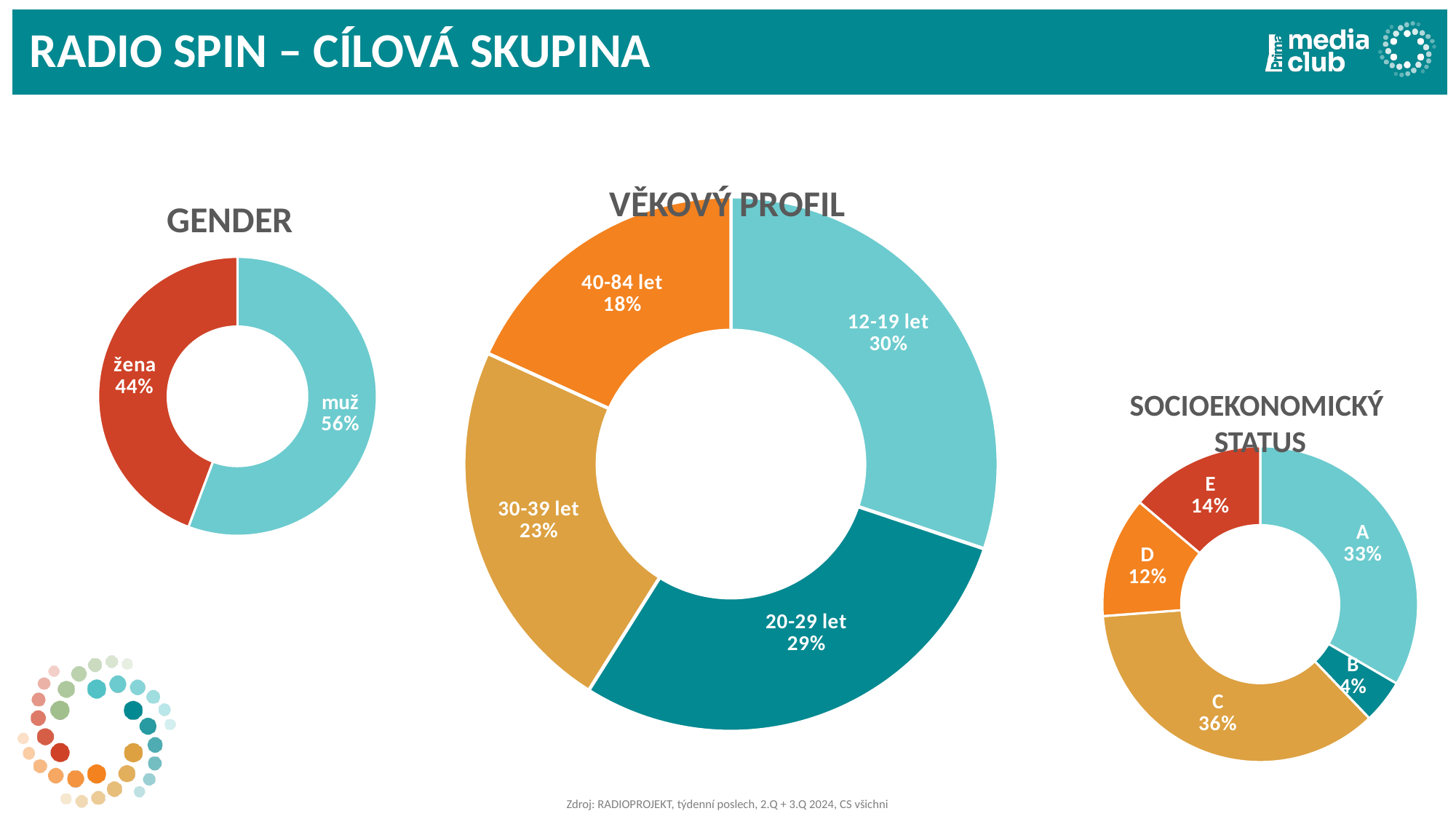
In the VĚKOVÝ PROFIL chart, what is the share for 20-29 let? 29% In the GENDER chart, what is the share for muž? 56% In the VĚKOVÝ PROFIL chart, which age group has the largest share? 12-19 let In the SOCIOEKONOMICKÝ STATUS chart, what is the share for D? 12% In the VĚKOVÝ PROFIL chart, what is the difference between the 30-39 let and 40-84 let shares? 5% In the GENDER chart, what is the difference between the muž and žena shares? 12% In the VĚKOVÝ PROFIL chart, how many age groups are shown? 4 What kind of chart is the GENDER chart? Doughnut chart In the SOCIOEKONOMICKÝ STATUS chart, which category has the smallest share? B In the VĚKOVÝ PROFIL chart, which age group has the smallest share? 40-84 let In the SOCIOEKONOMICKÝ STATUS chart, which category has the largest share? C In the GENDER chart, what is the share for žena? 44%